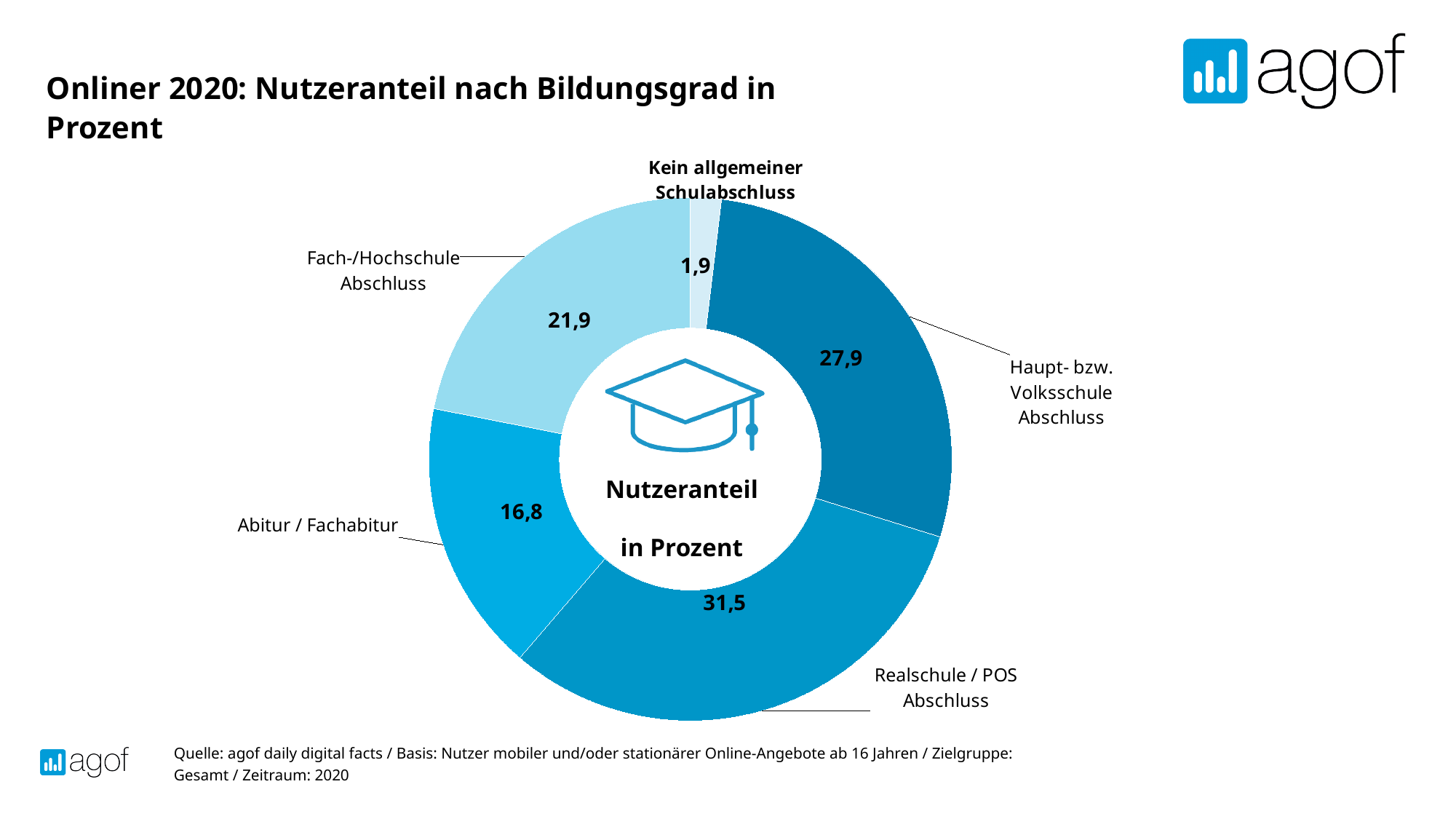
Which category has the highest share? Realschule / POS Abschluss What is the value for Abitur / Fachabitur? 16,8 What kind of chart is shown on the slide? Donut (pie) chart What is the value for Haupt- bzw. Volksschule Abschluss? 27,9 What is the value for Realschule / POS Abschluss? 31,5 What is the value for Kein allgemeiner Schulabschluss? 1,9 Which is larger, the value for Haupt- bzw. Volksschule Abschluss or the value for Fach-/Hochschule Abschluss? Haupt- bzw. Volksschule Abschluss What is the difference between the values for Fach-/Hochschule Abschluss and Abitur / Fachabitur? 5,1 What is the difference between the values for Realschule / POS Abschluss and Haupt- bzw. Volksschule Abschluss? 3,6 What is the value for Fach-/Hochschule Abschluss? 21,9 Which category has the lowest share? Kein allgemeiner Schulabschluss How many categories does the chart show? 5